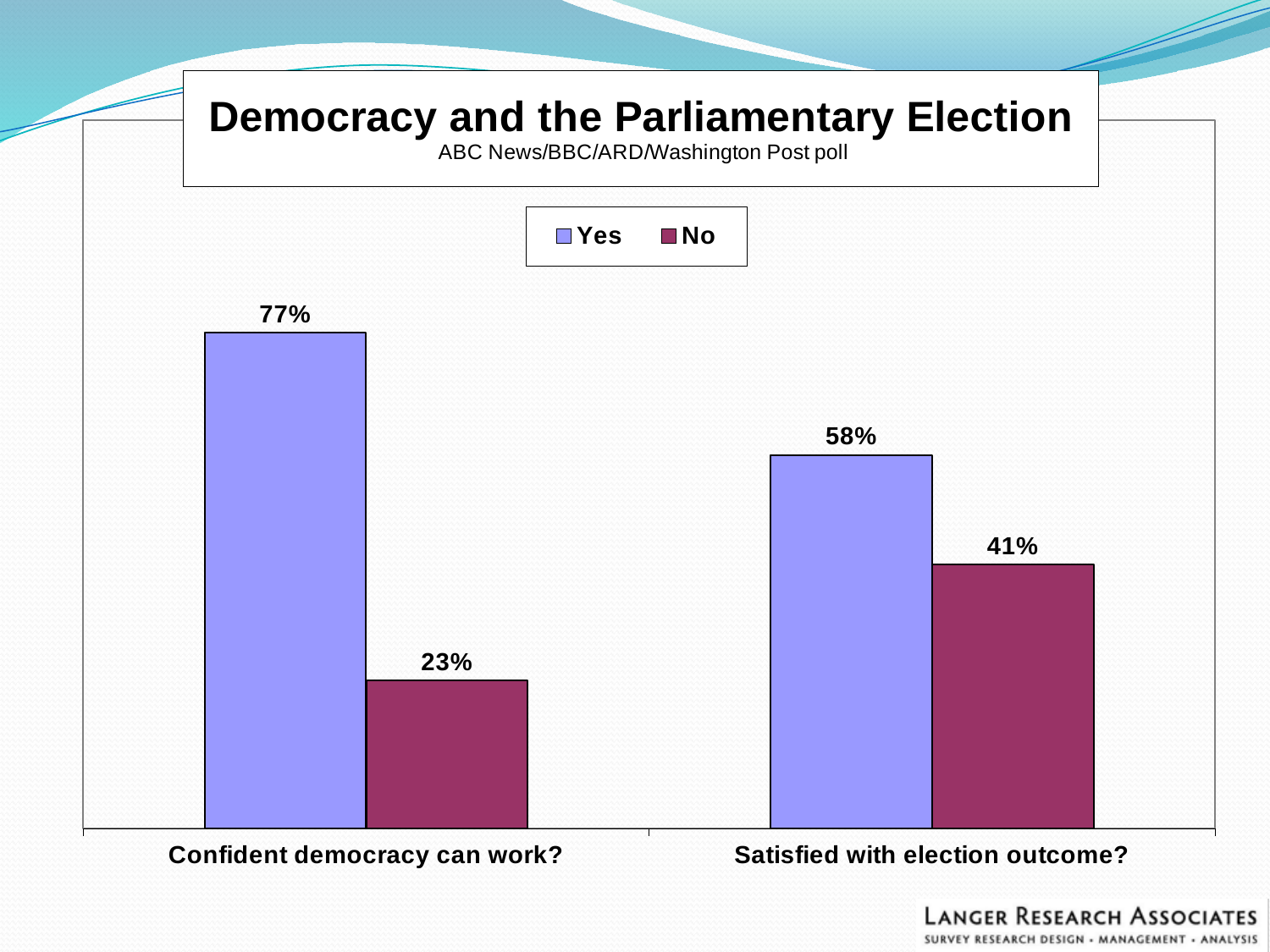
Is the No percentage larger for "Confident democracy can work?" or for "Satisfied with election outcome?" Satisfied with election outcome? Which question has the highest Yes percentage? Confident democracy can work? How many series does the legend list? 2 What is the title of the chart? Democracy and the Parliamentary Election What percentage answered Yes to "Satisfied with election outcome?" 58% What is the difference between the Yes and No percentages for "Satisfied with election outcome?" 17% Which question has the lowest No percentage? Confident democracy can work? What kind of chart is shown on the slide? Bar chart What percentage answered Yes to "Confident democracy can work?" 77% What percentage answered No to "Satisfied with election outcome?" 41% What is the difference between the Yes and No percentages for "Confident democracy can work?" 54% What percentage answered No to "Confident democracy can work?" 23%